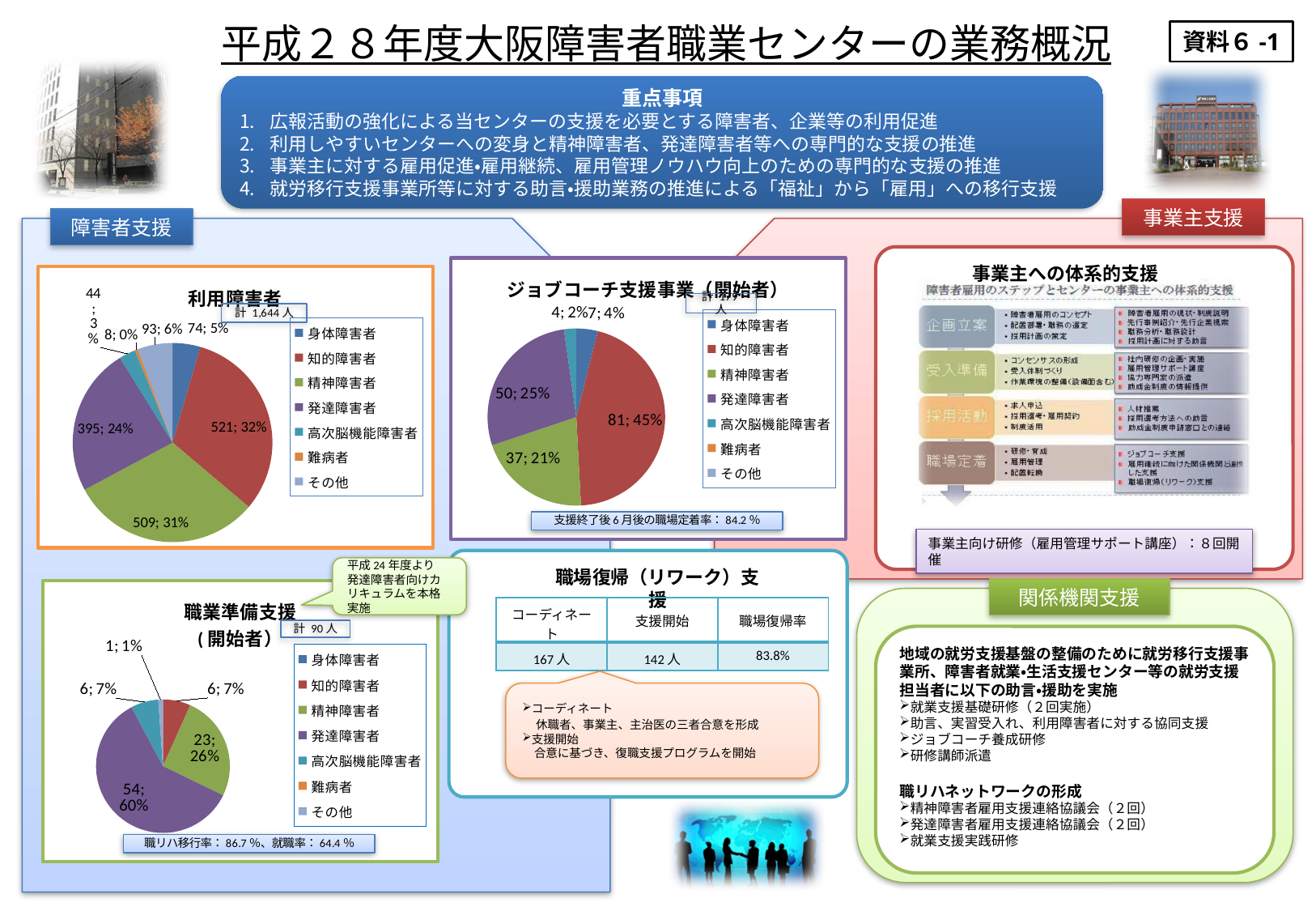
In the 利用障害者 pie chart, what is the difference between the counts for 知的障害者 and 精神障害者? 12 In the 利用障害者 pie chart, which category has the largest slice? 知的障害者 In the ジョブコーチ支援事業（開始者） pie chart, which is larger, the slice for 精神障害者 or the slice for 発達障害者? 発達障害者 In the ジョブコーチ支援事業（開始者） pie chart, what is the value shown for 発達障害者? 50; 25% In the 利用障害者 pie chart, what is the value shown for 発達障害者? 395; 24% In the 職業準備支援（開始者） pie chart, what is the value shown for 発達障害者? 54; 60% In the 利用障害者 pie chart, what is the total number of people shown in the label above the chart? 計 1,644人 In the 職業準備支援（開始者） pie chart, what share of the pie does 精神障害者 have? 26% In the 利用障害者 pie chart, what is the value shown for 知的障害者? 521; 32% How many entries does the legend of the 利用障害者 pie chart list? 7 In the ジョブコーチ支援事業（開始者） pie chart, what is the value shown for 知的障害者? 81; 45% What type of chart is used for 職業準備支援（開始者）? pie chart